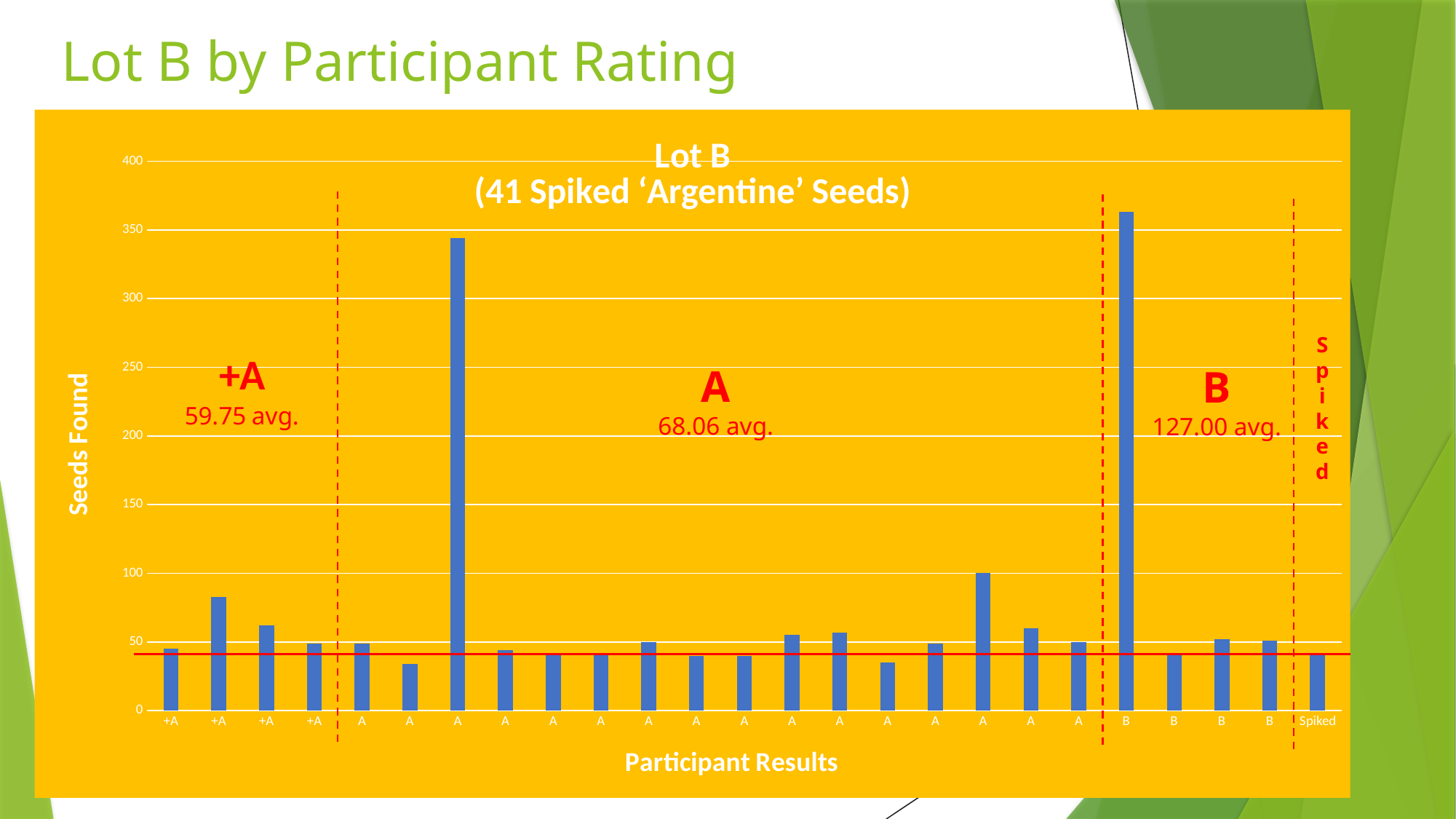
How many bars are labelled +A on the x axis? 4 What is the difference between the B group average and the +A group average? 67.25 What average is shown for the +A group? 59.75 avg. How many bars are plotted in the chart? 25 Is the value of the tallest bar in the B group greater or less than 350? greater What average is shown for the B group? 127.00 avg. What is the label of the vertical axis? Seeds Found What average is shown for the A group? 68.06 avg. How many bars are labelled B on the x axis? 4 What is the title of the chart? Lot B (41 Spiked 'Argentine' Seeds) Which participant rating group has the highest average shown? B What kind of chart is shown on the slide? Bar chart